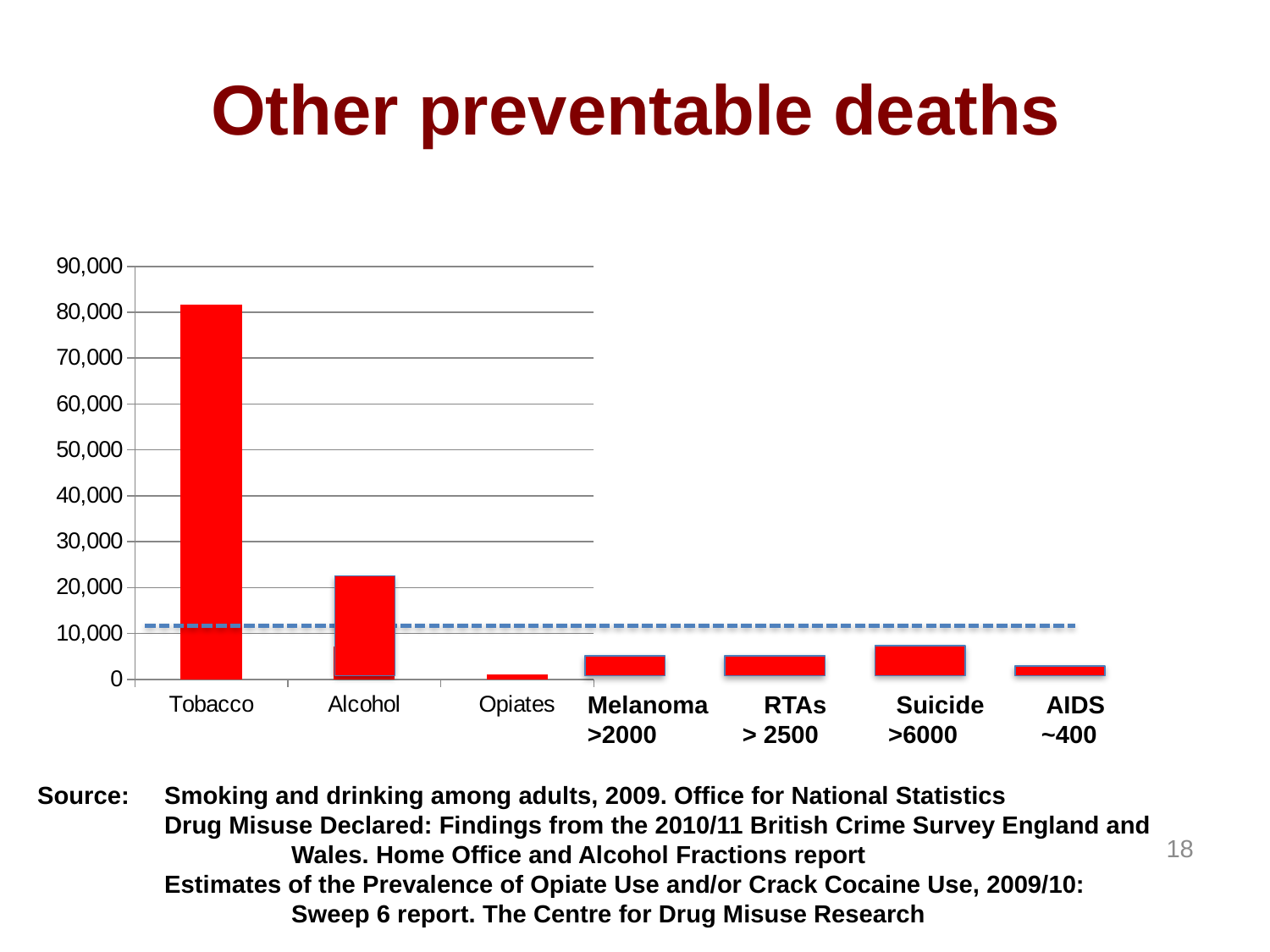
Is the value for Suicide greater or less than 10,000? less What is the highest value shown on the y axis of the chart? 90,000 What kind of chart is shown on the slide? bar chart Which is larger, the value for Suicide or the value for AIDS? Suicide Which category has the lowest bar in the chart? Opiates Which is larger, the value for Tobacco or the value for Alcohol? Tobacco What is the title of the slide containing the chart? Other preventable deaths Which category has the highest bar in the chart? Tobacco Which is larger, the value for Alcohol or the value for Suicide? Alcohol Is the value for Tobacco greater or less than 70,000? greater Is the value for Alcohol greater or less than 30,000? less